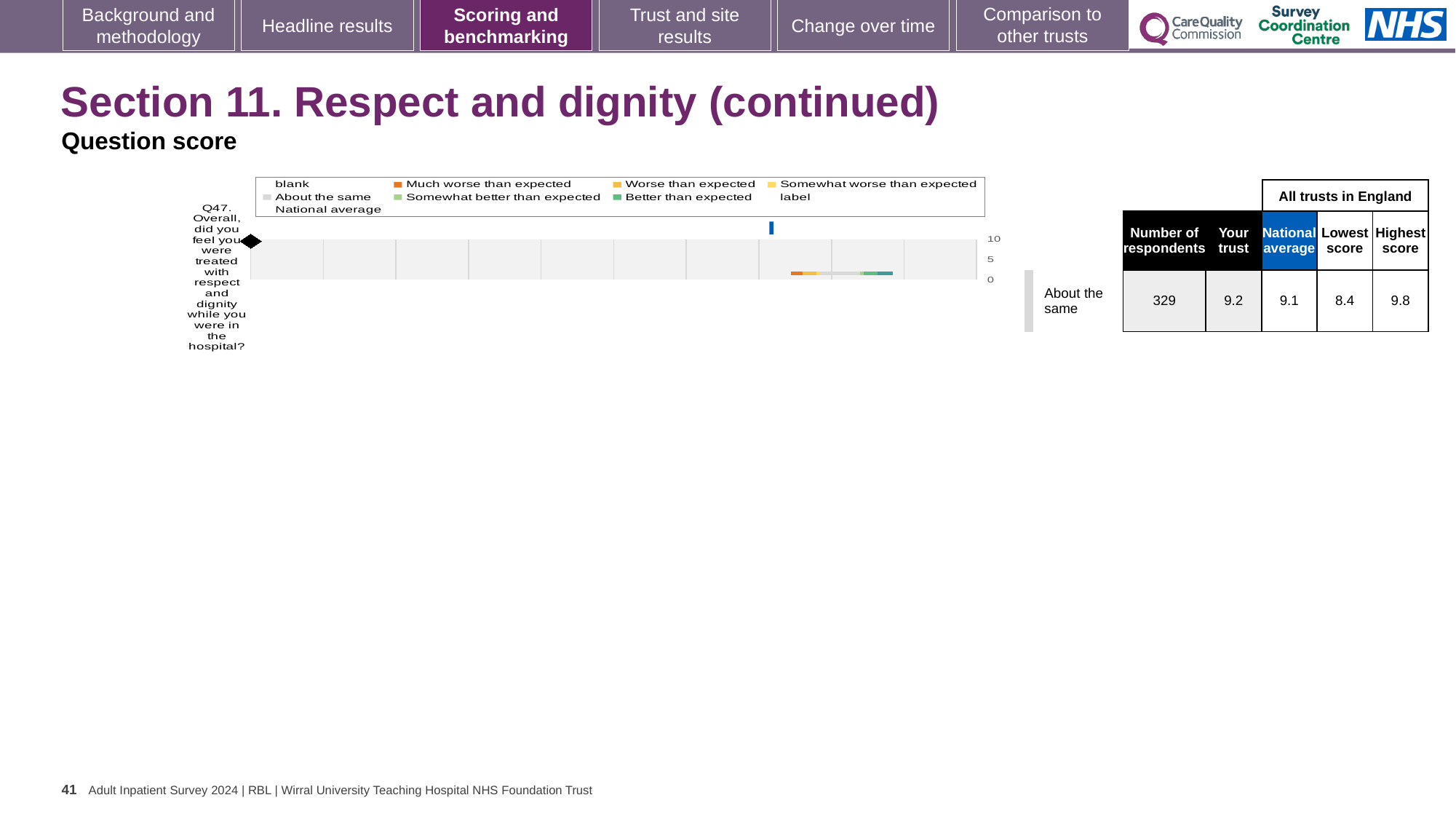
In the table beside the chart, what is the lowest score among all trusts in England for Q47? 8.4 Which is larger for Q47, the 'Your trust' score or the national average? Your trust Which question number is plotted in the chart? Q47 In the table beside the chart, what is the 'Your trust' score for Q47? 9.2 What is the difference between the highest score and the lowest score for Q47 in the table? 1.4 How many questions are plotted in the chart? 1 In the table beside the chart, how many respondents are listed for Q47? 329 In the table beside the chart, what is the highest score among all trusts in England for Q47? 9.8 In the table beside the chart, what is the national average score for Q47? 9.1 What kind of chart is shown on the slide for Q47? bar chart How many entries does the chart legend list? 9 What benchmark category is shown for the trust's result on Q47? About the same